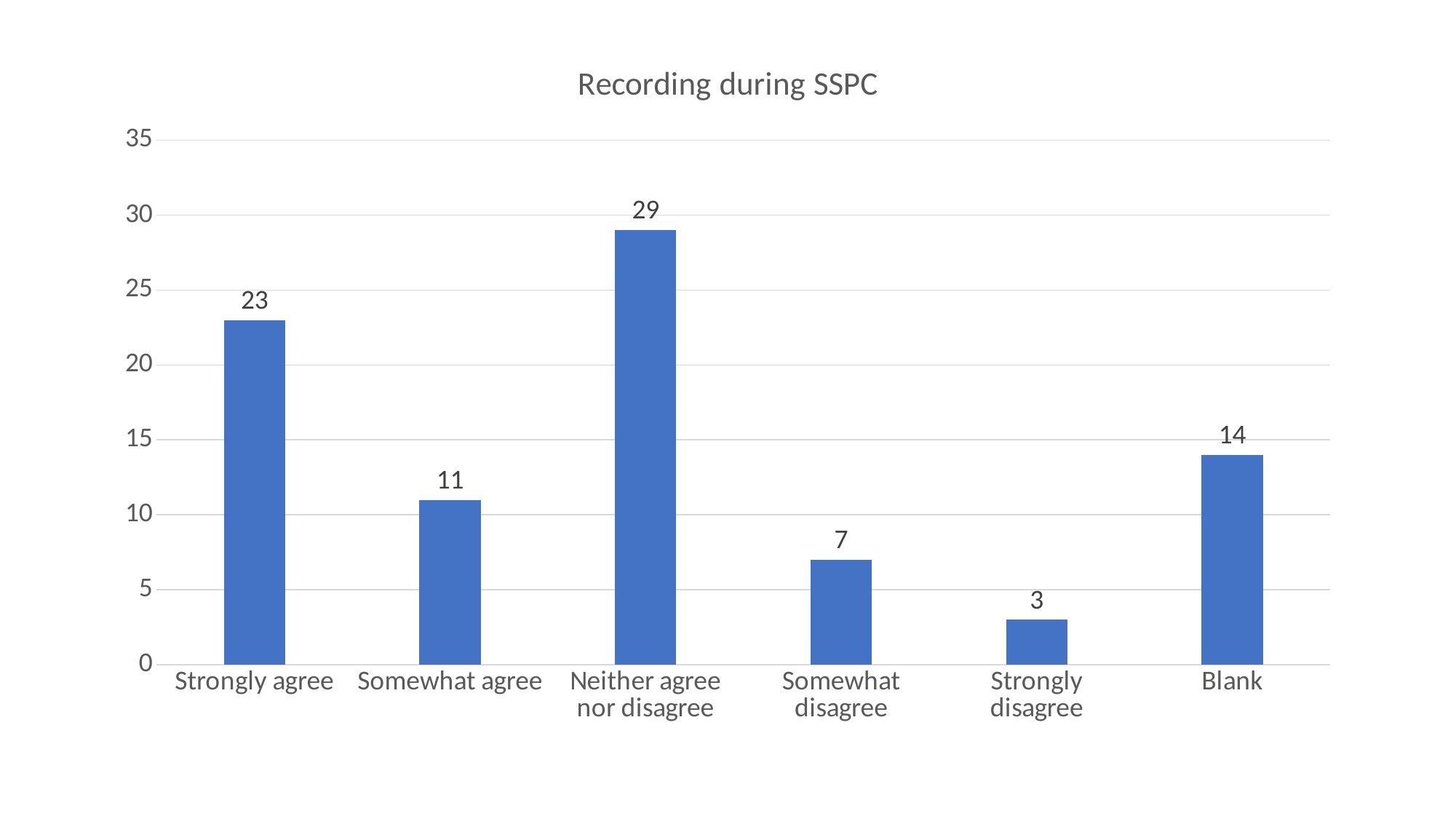
What is the title of the chart? Recording during SSPC What is the difference between the values for Neither agree nor disagree and Strongly disagree? 26 Which category has the highest value? Neither agree nor disagree What is the value for Blank? 14 What is the value for Neither agree nor disagree? 29 How many categories are shown on the x axis? 6 What is the value for Strongly agree? 23 Which is larger, the value for Somewhat disagree or the value for Blank? Blank Which category has the lowest value? Strongly disagree Is the value for Somewhat agree greater or less than 10? greater What is the difference between the values for Strongly agree and Somewhat agree? 12 What kind of chart is shown on the slide? bar chart